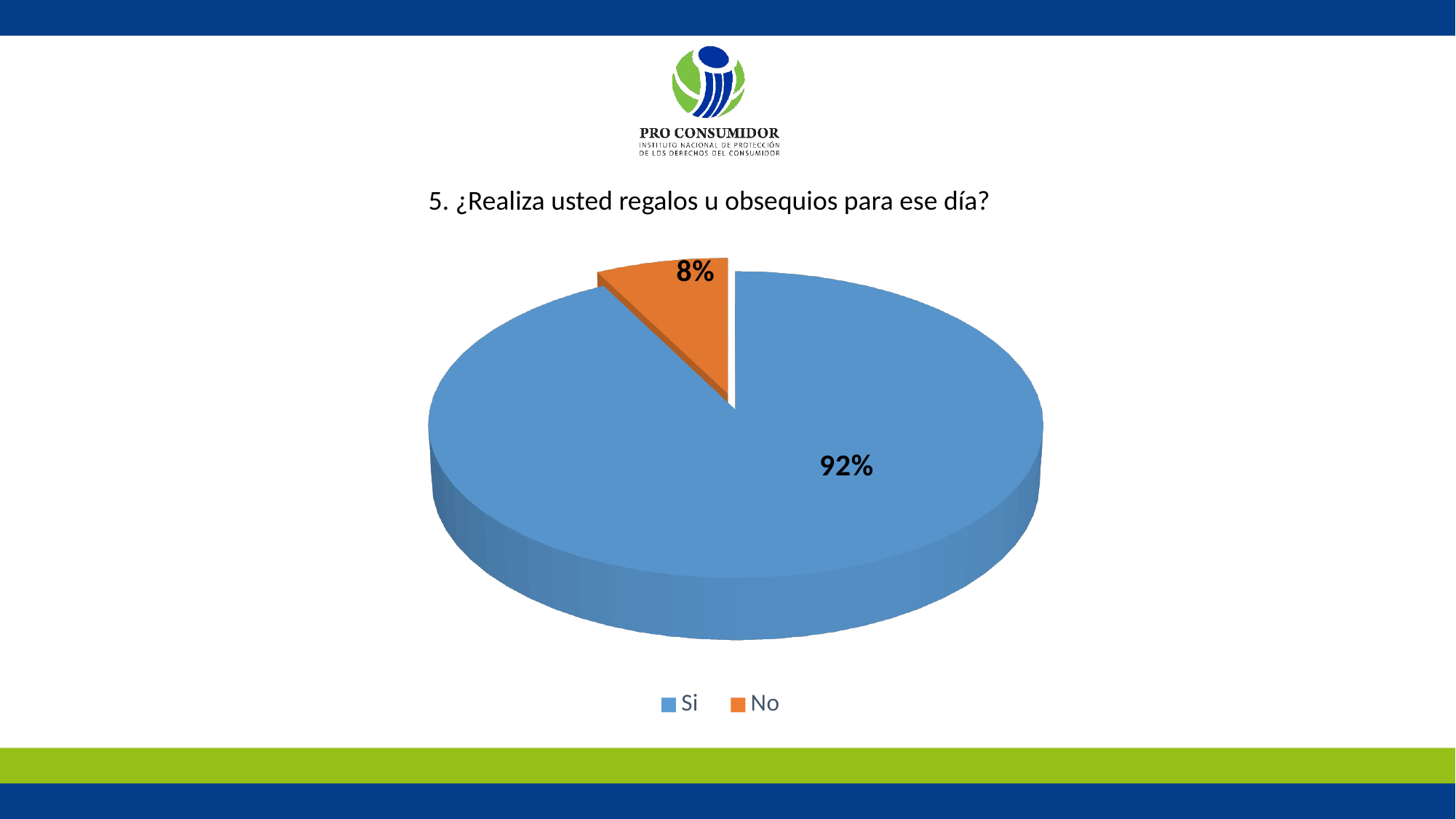
What is the title of the chart? 5. ¿Realiza usted regalos u obsequios para ese día? What percentage of respondents answered "No"? 8% What colour is the "No" slice? Orange What percentage of respondents answered "Si"? 92% What kind of chart is shown on the slide? Pie chart Which slice is larger, "Si" or "No"? Si How many slices does the pie chart have? 2 How many entries does the legend list? 2 Which response has the smallest share of the pie? No What share of the pie does the "No" slice represent? 8% What is the difference in percentage points between the "Si" and "No" slices? 84 Which response has the largest share of the pie? Si